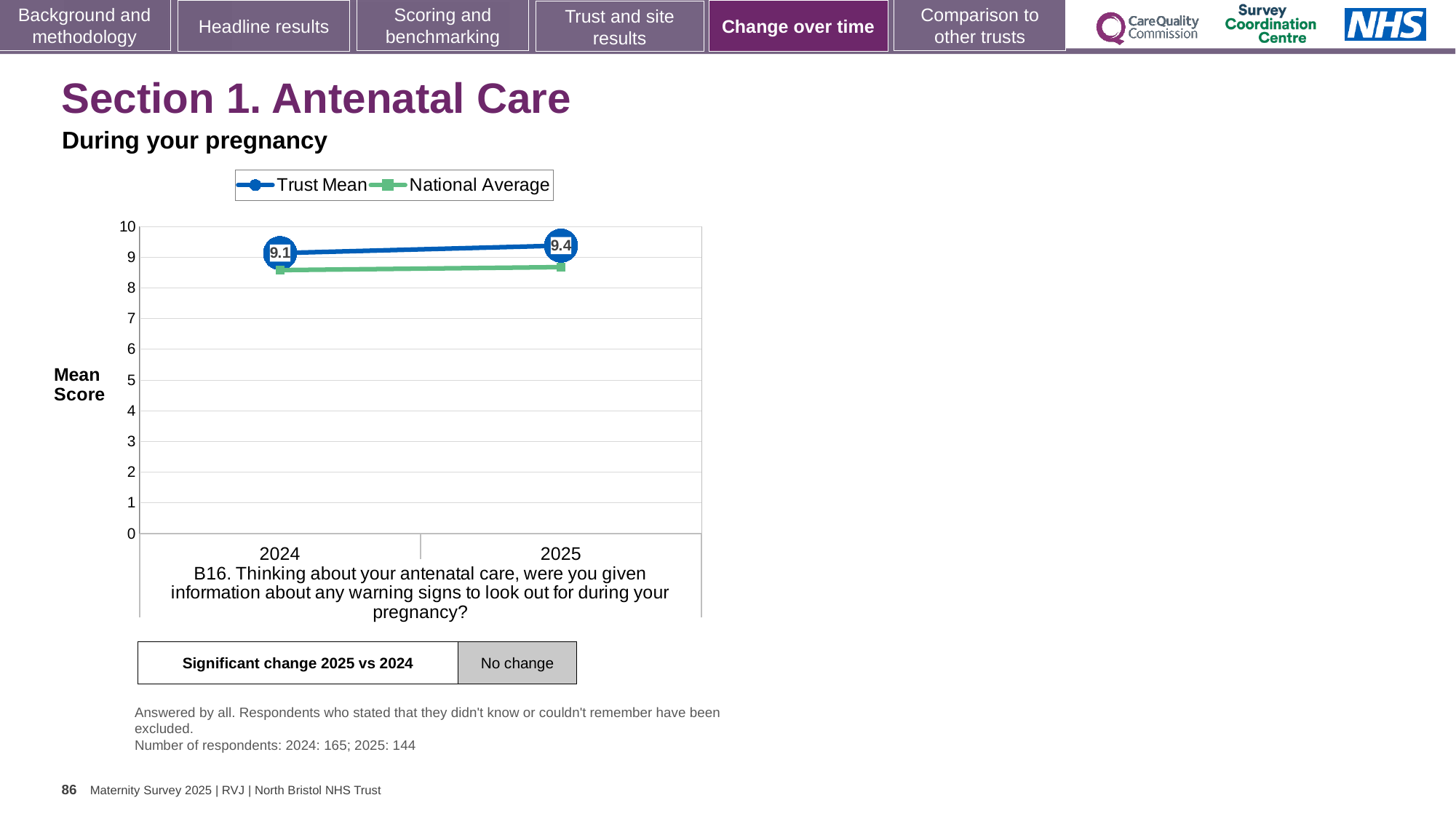
What is the difference between the Trust Mean scores for 2025 and 2024? 0.3 Is the National Average for 2025 greater or less than 8? greater Does the Trust Mean rise or fall from 2024 to 2025? rise What kind of chart is shown on the slide? line chart What is the Trust Mean score for 2025? 9.4 Is the National Average for 2024 greater or less than 9? less Is the Trust Mean for 2025 greater or less than the Trust Mean for 2024? greater How many years are plotted on the x axis? 2 What is the Trust Mean score for 2024? 9.1 Which year has the higher Trust Mean score? 2025 How many series does the legend list? 2 Which year has the lower Trust Mean score? 2024